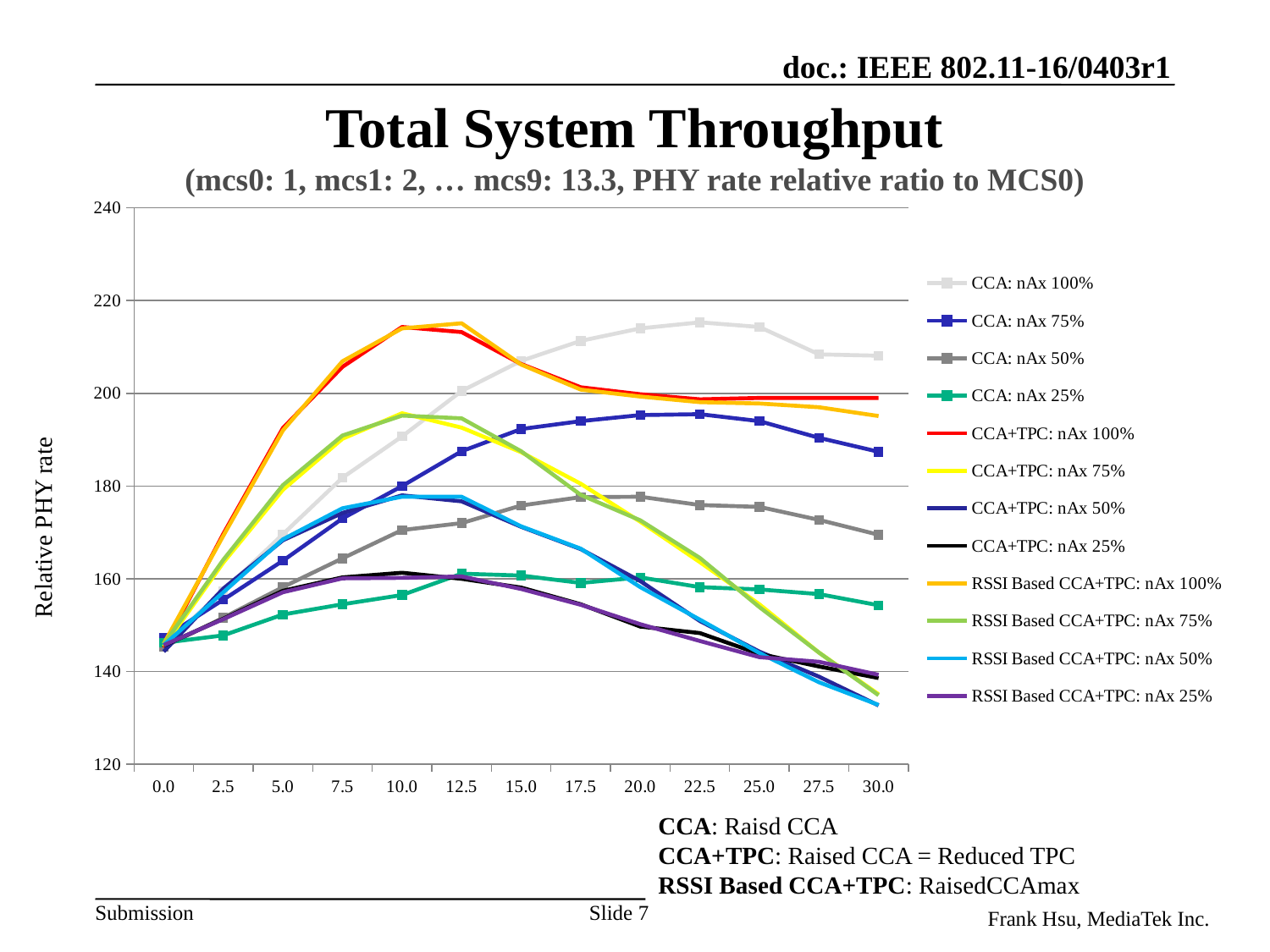
Does the RSSI Based CCA+TPC: nAx 50% series rise or fall from x = 12.5 to x = 30.0? fall What is the title of the chart? Total System Throughput Is the value for CCA: nAx 100% at x = 22.5 greater or less than 200? greater What is the label of the y axis? Relative PHY rate At x = 30.0, which is larger: CCA: nAx 100% or CCA: nAx 25%? CCA: nAx 100% Which series has the highest value at x = 30.0? CCA: nAx 100% Is the value for CCA+TPC: nAx 75% at x = 12.5 greater or less than 180? greater How many x-axis tick values are shown along the x axis? 13 How many series does the legend list? 12 Is the value for CCA: nAx 25% at x = 30.0 greater or less than 160? less What kind of chart is shown on the slide? line chart